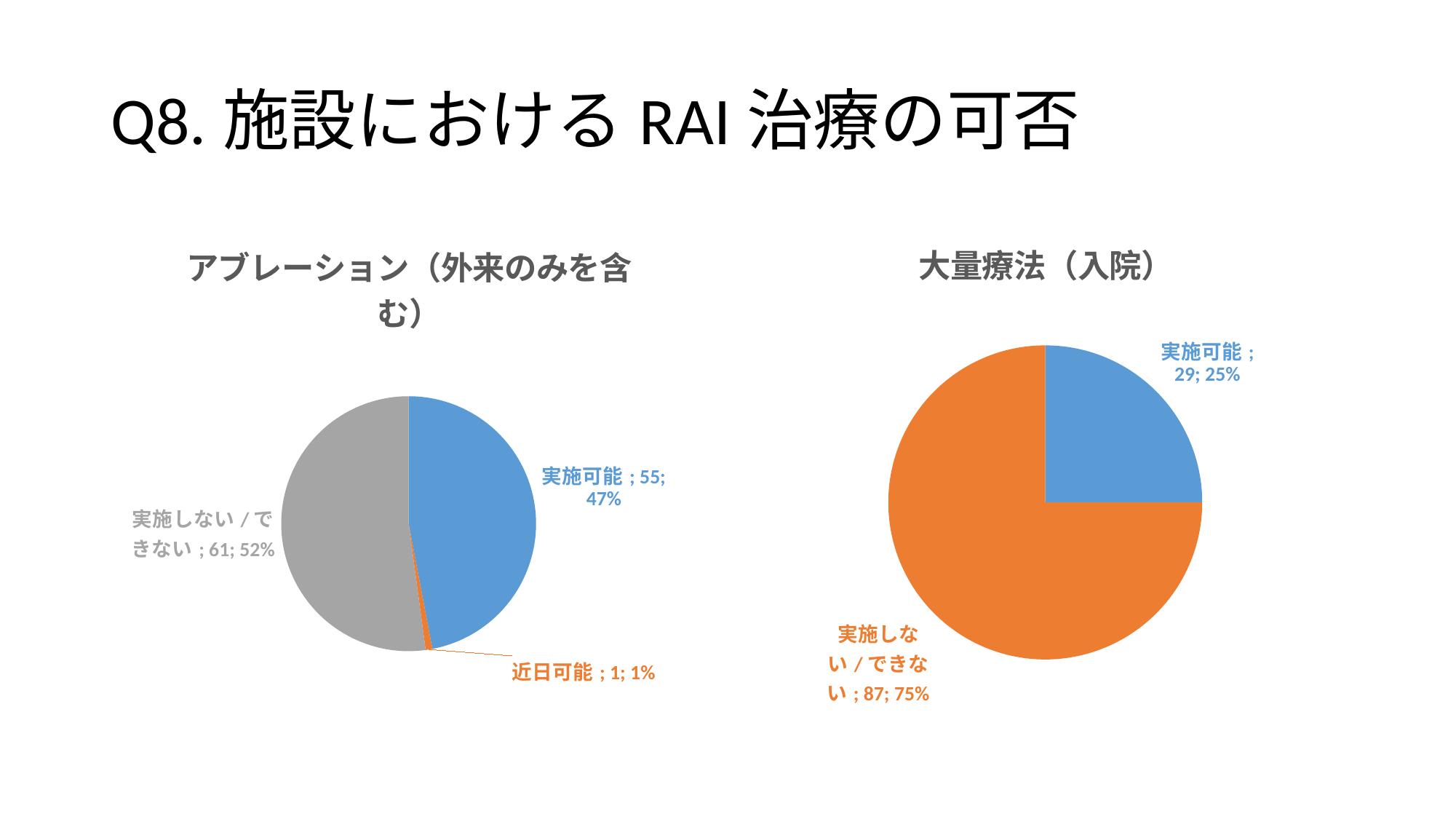
In the left pie chart (アブレーション（外来のみを含む）), how many slices are there? 3 In the right pie chart (大量療法（入院）), which is larger, 実施可能 or 実施しない / できない? 実施しない / できない In the left pie chart (アブレーション（外来のみを含む）), what share of the pie is 実施しない / できない? 52% What type of chart is used on the right (大量療法（入院）)? Pie chart In the right pie chart (大量療法（入院）), what is the difference between the counts for 実施しない / できない and 実施可能? 58 In the left pie chart (アブレーション（外来のみを含む）), which category has the smallest slice? 近日可能 In the left pie chart (アブレーション（外来のみを含む）), what is the count for 実施可能? 55 What colour is the 実施可能 slice in the right pie chart (大量療法（入院）)? Blue In the right pie chart (大量療法（入院）), what share of the pie is 実施しない / できない? 75% In the left pie chart (アブレーション（外来のみを含む）), what is the count for 近日可能? 1 In the right pie chart (大量療法（入院）), what is the count for 実施可能? 29 In the left pie chart (アブレーション（外来のみを含む）), which category has the largest slice? 実施しない / できない